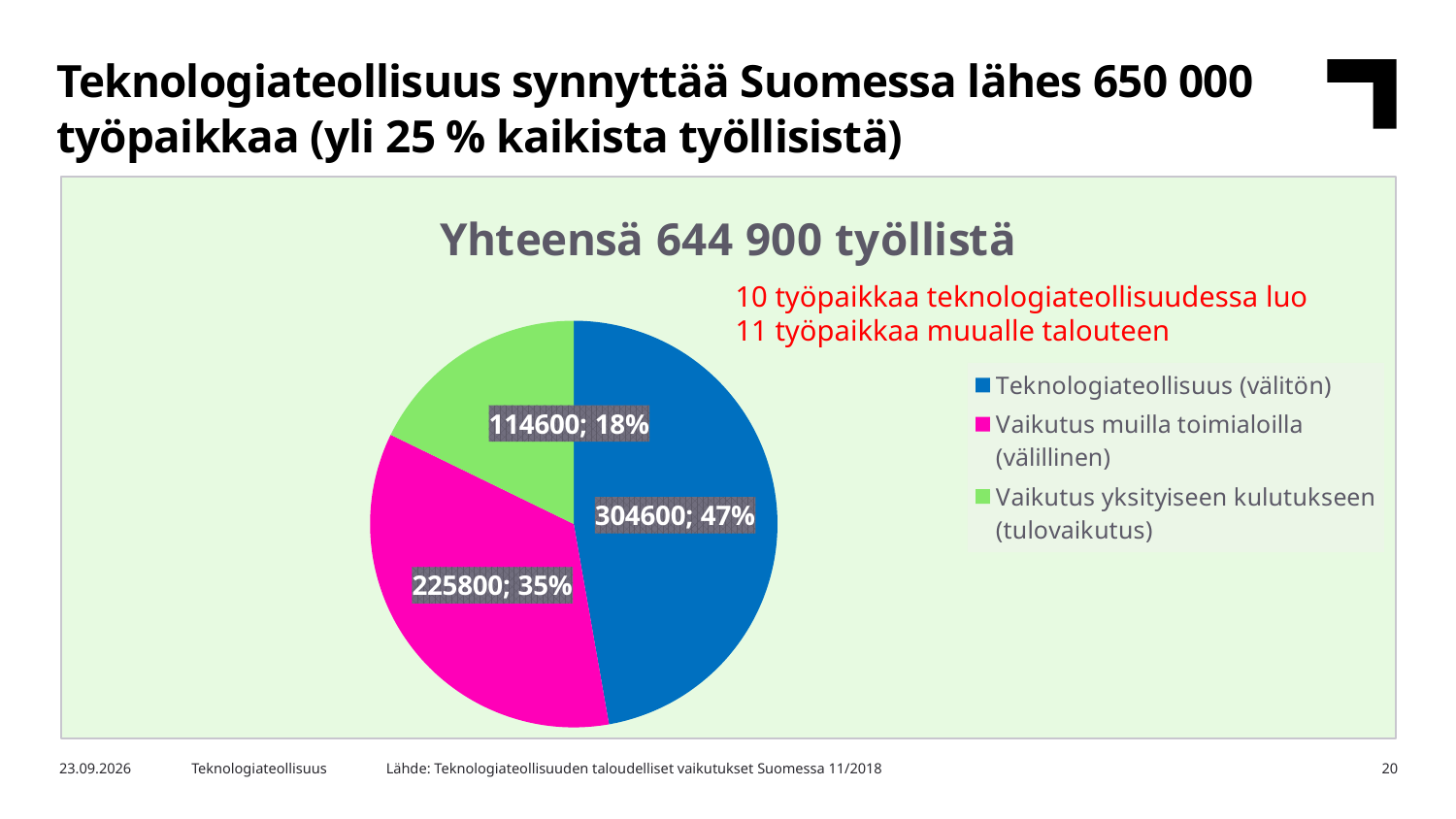
Which category has the largest slice of the pie? Teknologiateollisuus (välitön) How many slices does the pie chart have? 3 What is the value for Teknologiateollisuus (välitön)? 304600 What share of the pie does Teknologiateollisuus (välitön) represent? 47% What is the value for Vaikutus yksityiseen kulutukseen (tulovaikutus)? 114600 Which is larger: the value for Vaikutus muilla toimialoilla (välillinen) or Vaikutus yksityiseen kulutukseen (tulovaikutus)? Vaikutus muilla toimialoilla (välillinen) What is the value for Vaikutus muilla toimialoilla (välillinen)? 225800 What type of chart is shown on the slide? pie chart What is the title of the chart? Yhteensä 644 900 työllistä What share of the pie does Vaikutus yksityiseen kulutukseen (tulovaikutus) represent? 18% What is the difference between the values for Teknologiateollisuus (välitön) and Vaikutus muilla toimialoilla (välillinen)? 78800 Which category has the smallest slice of the pie? Vaikutus yksityiseen kulutukseen (tulovaikutus)